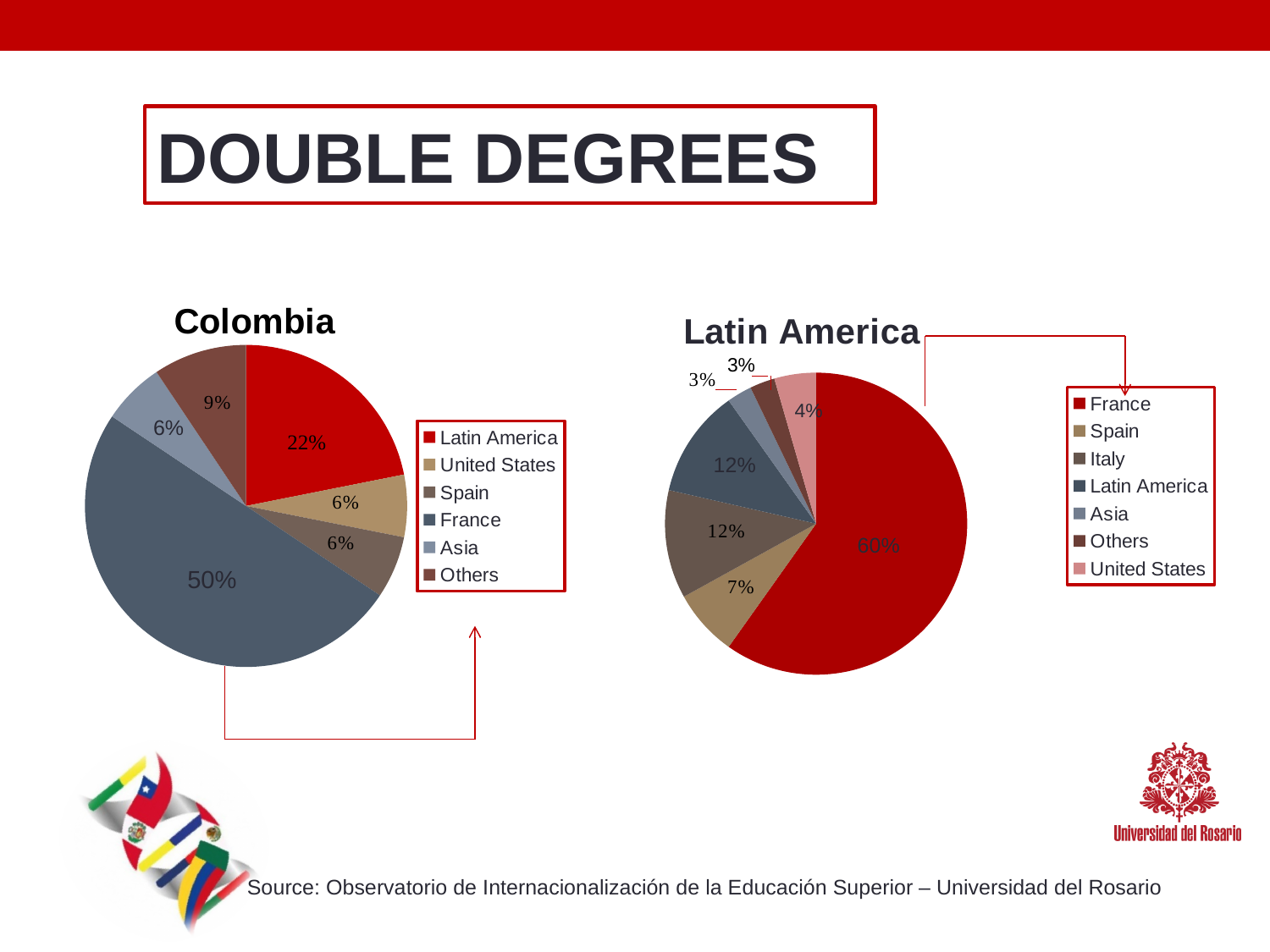
In the Colombia chart, what share does Latin America have? 22% What type of chart is the Colombia chart? Pie chart In the Colombia chart, what share does France have? 50% In the Colombia chart, what is the difference between the France share and the Latin America share? 28% In the Colombia chart, what share does Others have? 9% In the Latin America chart, what share does United States have? 4% In the Latin America chart, what share does Spain have? 7% In the Latin America chart, which is larger, the Italy share or the Spain share? Italy In the Latin America chart, what share does France have? 60% How many categories does the legend of the Latin America chart list? 7 In the Latin America chart, which category has the largest slice? France In the Colombia chart, which category has the largest slice? France